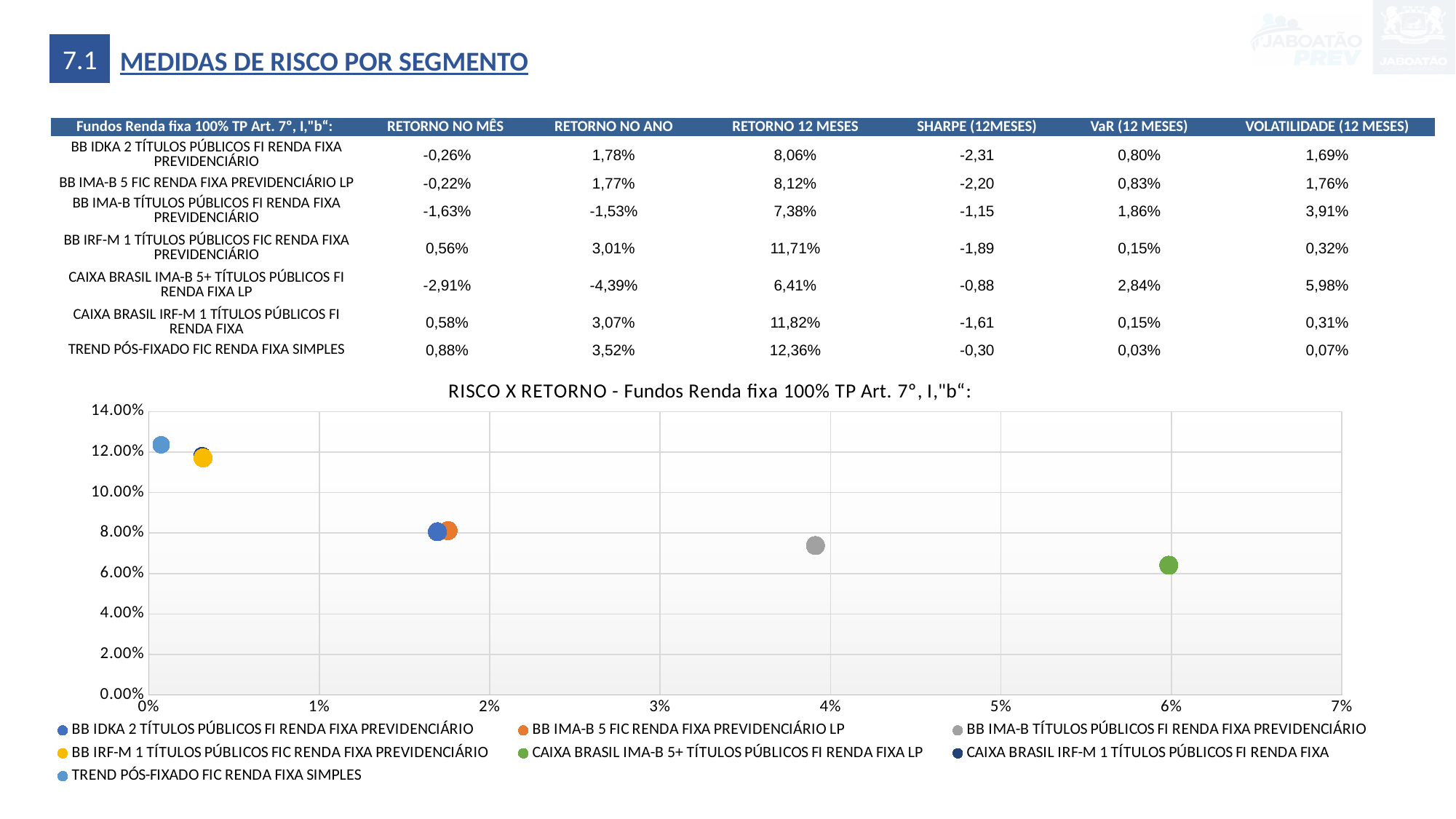
How many series does the legend of the RISCO X RETORNO chart list? 7 In the RISCO X RETORNO chart, is the volatility (x-axis value) for BB IMA-B TÍTULOS PÚBLICOS FI RENDA FIXA PREVIDENCIÁRIO greater or less than 3%? greater In the RISCO X RETORNO chart, is the return value for TREND PÓS-FIXADO FIC RENDA FIXA SIMPLES greater or less than 10.00%? greater What is the highest value shown on the x axis of the RISCO X RETORNO chart? 7% In the RISCO X RETORNO chart, which fund is plotted furthest to the right (highest volatility)? CAIXA BRASIL IMA-B 5+ TÍTULOS PÚBLICOS FI RENDA FIXA LP In the RISCO X RETORNO chart, which fund has the highest 12-month return (highest point on the y axis)? TREND PÓS-FIXADO FIC RENDA FIXA SIMPLES In the RISCO X RETORNO chart, do the returns generally rise or fall as volatility increases along the x axis? Fall In the RISCO X RETORNO chart, is the return value for CAIXA BRASIL IMA-B 5+ TÍTULOS PÚBLICOS FI RENDA FIXA LP greater or less than 8.00%? less In the RISCO X RETORNO chart, which fund has the lowest 12-month return (lowest point on the y axis)? CAIXA BRASIL IMA-B 5+ TÍTULOS PÚBLICOS FI RENDA FIXA LP In the RISCO X RETORNO chart, which has the higher return: BB IMA-B TÍTULOS PÚBLICOS FI RENDA FIXA PREVIDENCIÁRIO or CAIXA BRASIL IMA-B 5+ TÍTULOS PÚBLICOS FI RENDA FIXA LP? BB IMA-B TÍTULOS PÚBLICOS FI RENDA FIXA PREVIDENCIÁRIO How many data points are plotted in the RISCO X RETORNO chart? 7 What kind of chart is shown under the title "RISCO X RETORNO"? Scatter chart